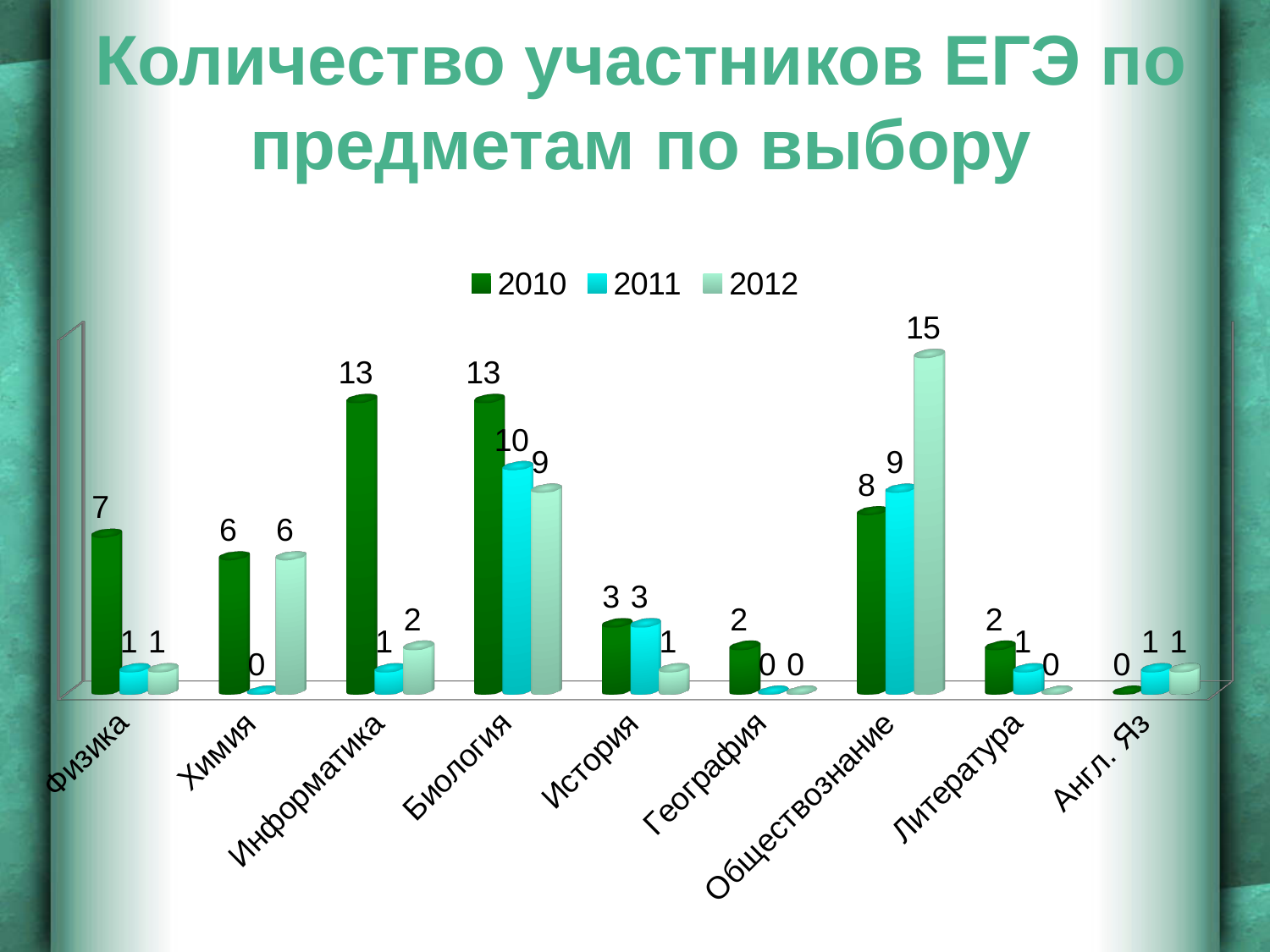
Which is larger for Обществознание: the 2010 value or the 2011 value? 2011 What is the value for Физика in the 2010 series? 7 What is the value for Биология in the 2011 series? 10 How many categories are shown on the x axis? 9 What is the title of the chart? Количество участников ЕГЭ по предметам по выбору What is the difference between the 2010 and 2012 values for Информатика? 11 What is the total of the three series values for Биология? 32 Which category has the lowest value in the 2010 series? Англ. Яз What kind of chart is shown on the slide? Bar chart How many series does the legend list? 3 Which category has the highest value in the 2012 series? Обществознание What is the value for Обществознание in the 2012 series? 15